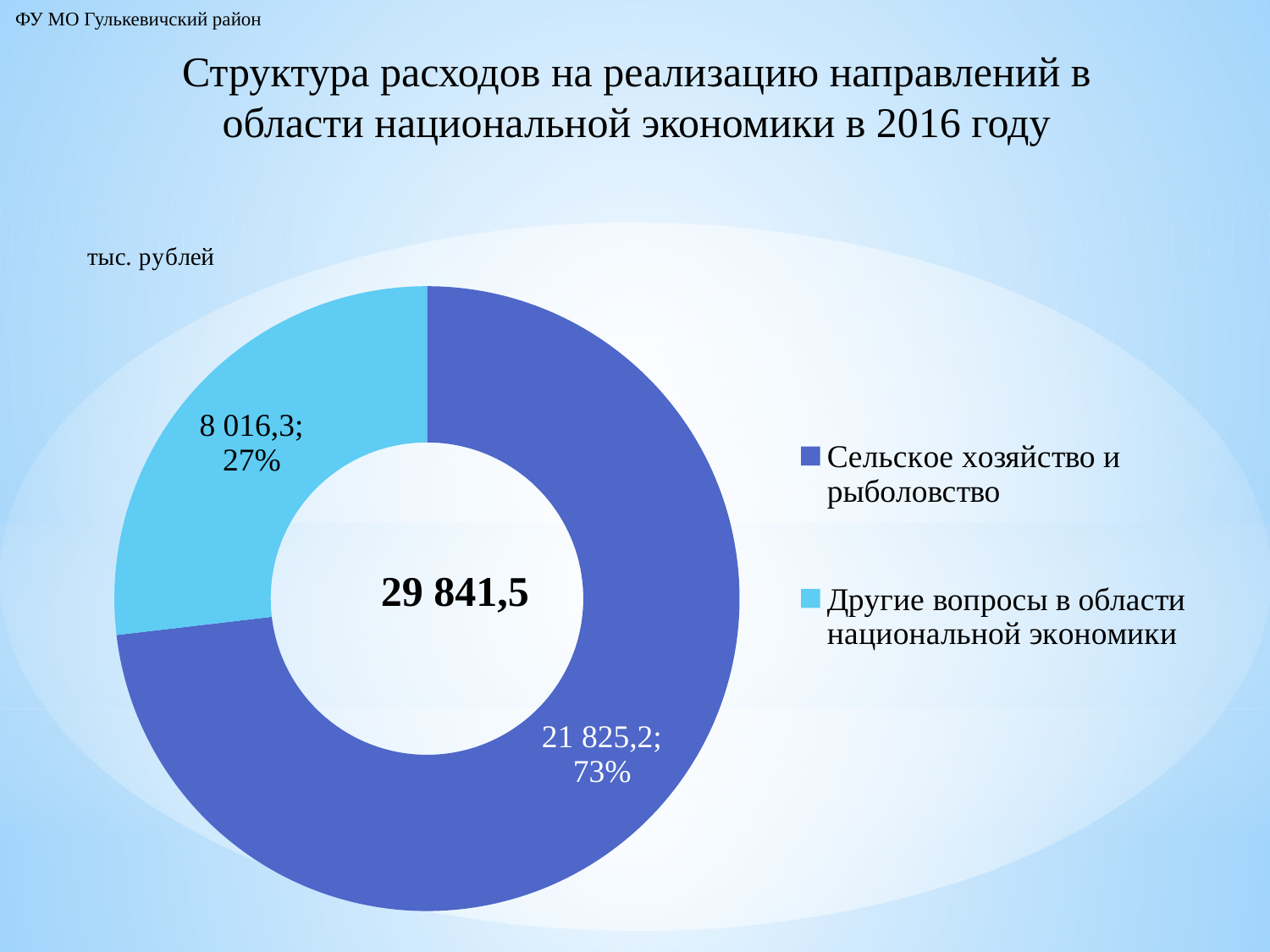
Which is larger: Сельское хозяйство и рыболовство or Другие вопросы в области национальной экономики? Сельское хозяйство и рыболовство What is the difference between the values for Сельское хозяйство и рыболовство and Другие вопросы в области национальной экономики? 13 808,9 Which category has the smallest slice? Другие вопросы в области национальной экономики How many categories does the chart show? 2 What is the value for Сельское хозяйство и рыболовство? 21 825,2 What is the value for Другие вопросы в области национальной экономики? 8 016,3 What share of the chart does Сельское хозяйство и рыболовство represent? 73% Which category has the largest slice? Сельское хозяйство и рыболовство What is the total value shown in the centre of the chart? 29 841,5 What share of the chart does Другие вопросы в области национальной экономики represent? 27% What kind of chart is shown on the slide? Doughnut (pie) chart In what units are the values on the chart expressed? тыс. рублей